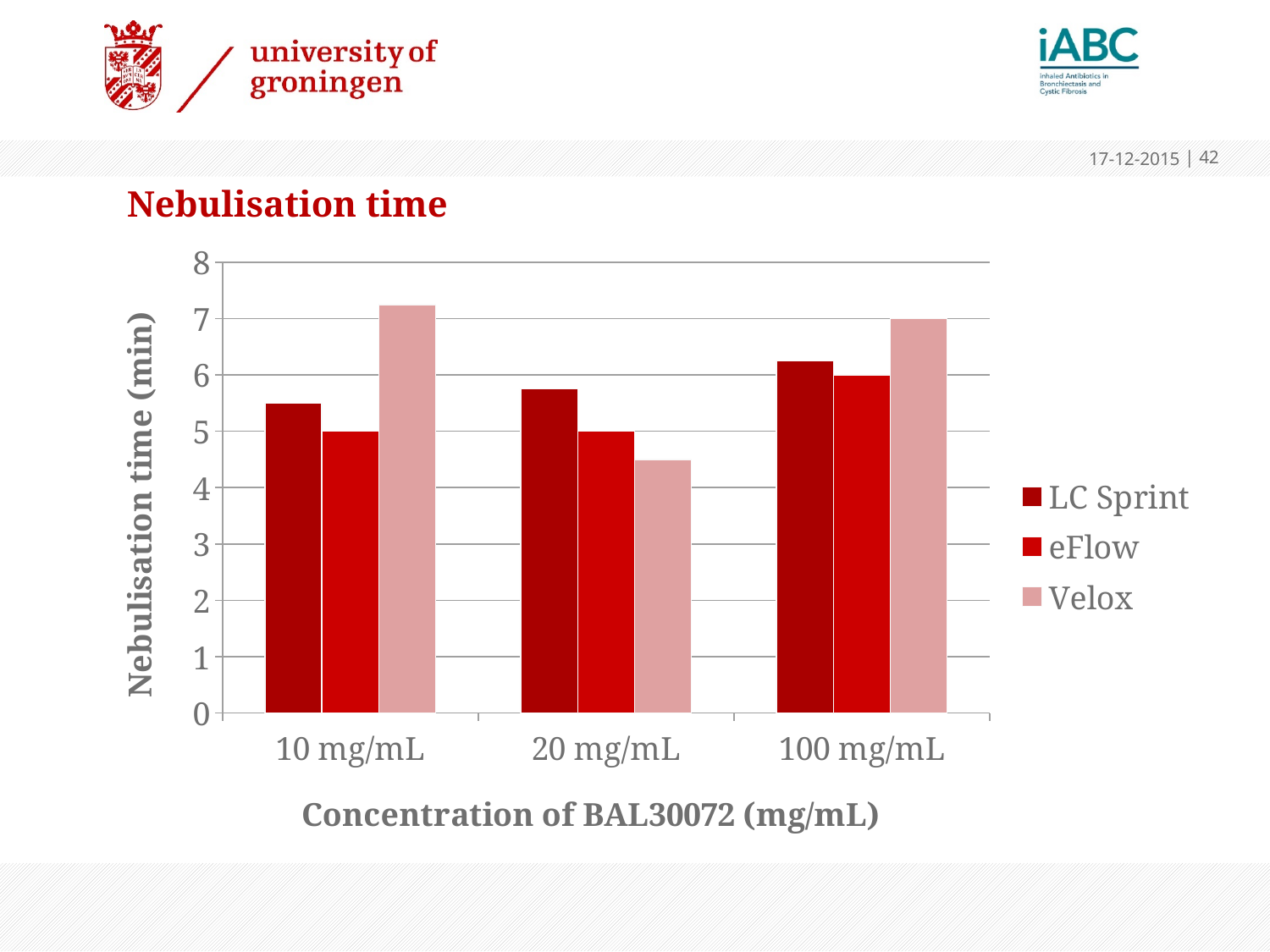
How many series does the legend list? 3 Is the value for LC Sprint at 100 mg/mL greater or less than 6? greater At which concentration is the Velox nebulisation time lowest? 20 mg/mL What is the nebulisation time for eFlow at 100 mg/mL? 6 What is the nebulisation time for eFlow at 20 mg/mL? 5 What kind of chart is shown on the slide? Bar chart How many concentration categories are shown on the x axis? 3 What is the nebulisation time for Velox at 100 mg/mL? 7 At 10 mg/mL, which has the larger nebulisation time, LC Sprint or eFlow? LC Sprint What is the title of the y axis? Nebulisation time (min) Is the value for Velox at 10 mg/mL greater or less than 7? greater Is the value for Velox at 20 mg/mL greater or less than 5? less